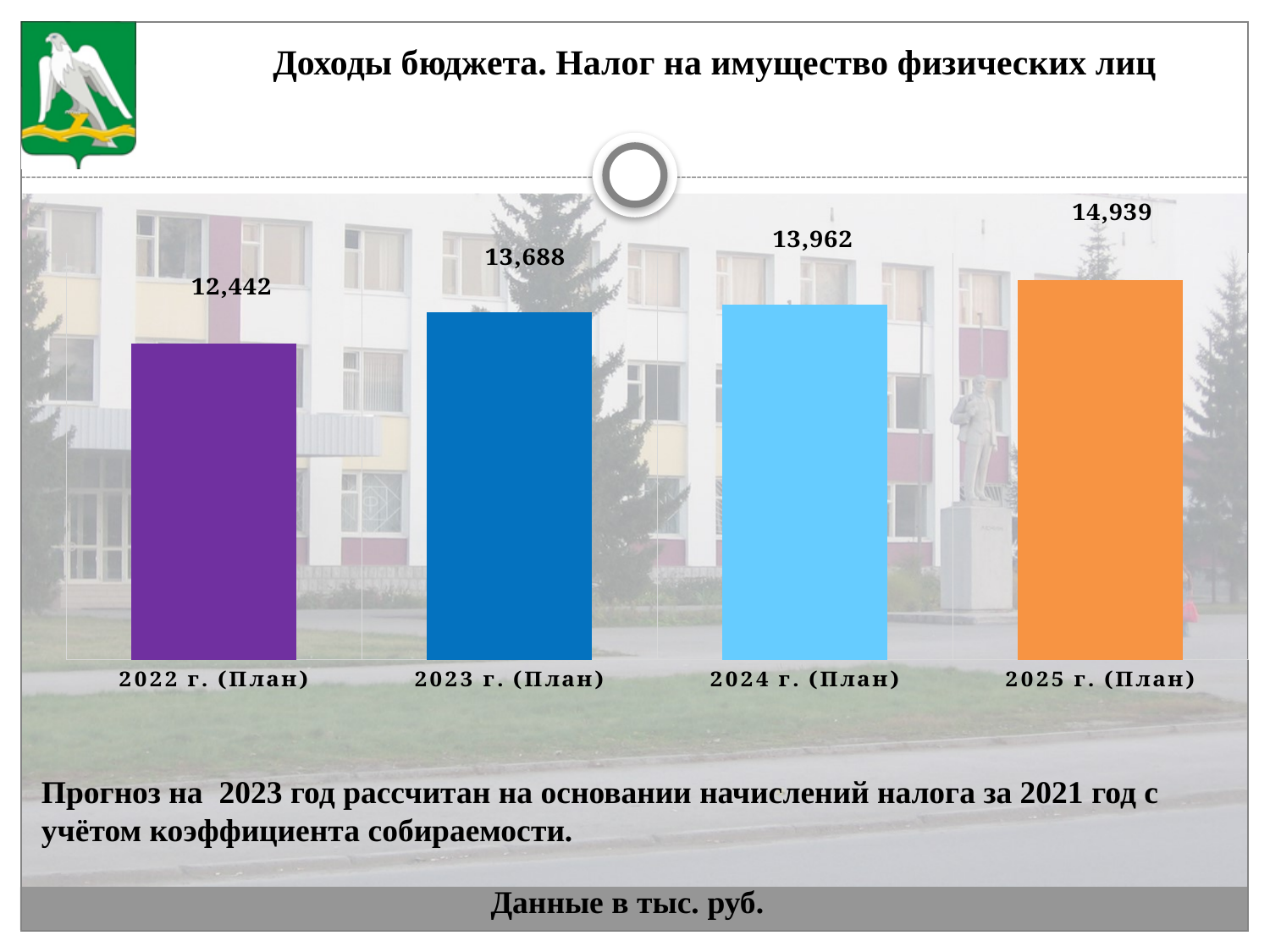
What is the value for 2022 г. (План)? 12,442 Which year has the highest value? 2025 г. (План) What is the value for 2023 г. (План)? 13,688 What kind of chart is shown on the slide? Bar chart How many bars are shown in the chart? 4 What is the value for 2025 г. (План)? 14,939 Which year has the lowest value? 2022 г. (План) What is the difference between the values for 2025 г. (План) and 2022 г. (План)? 2,497 Which is larger, the value for 2025 г. (План) or 2023 г. (План)? 2025 г. (План) What is the value for 2024 г. (План)? 13,962 Do the values rise or fall from 2022 to 2025? Rise What is the difference between the values for 2023 г. (План) and 2022 г. (План)? 1,246